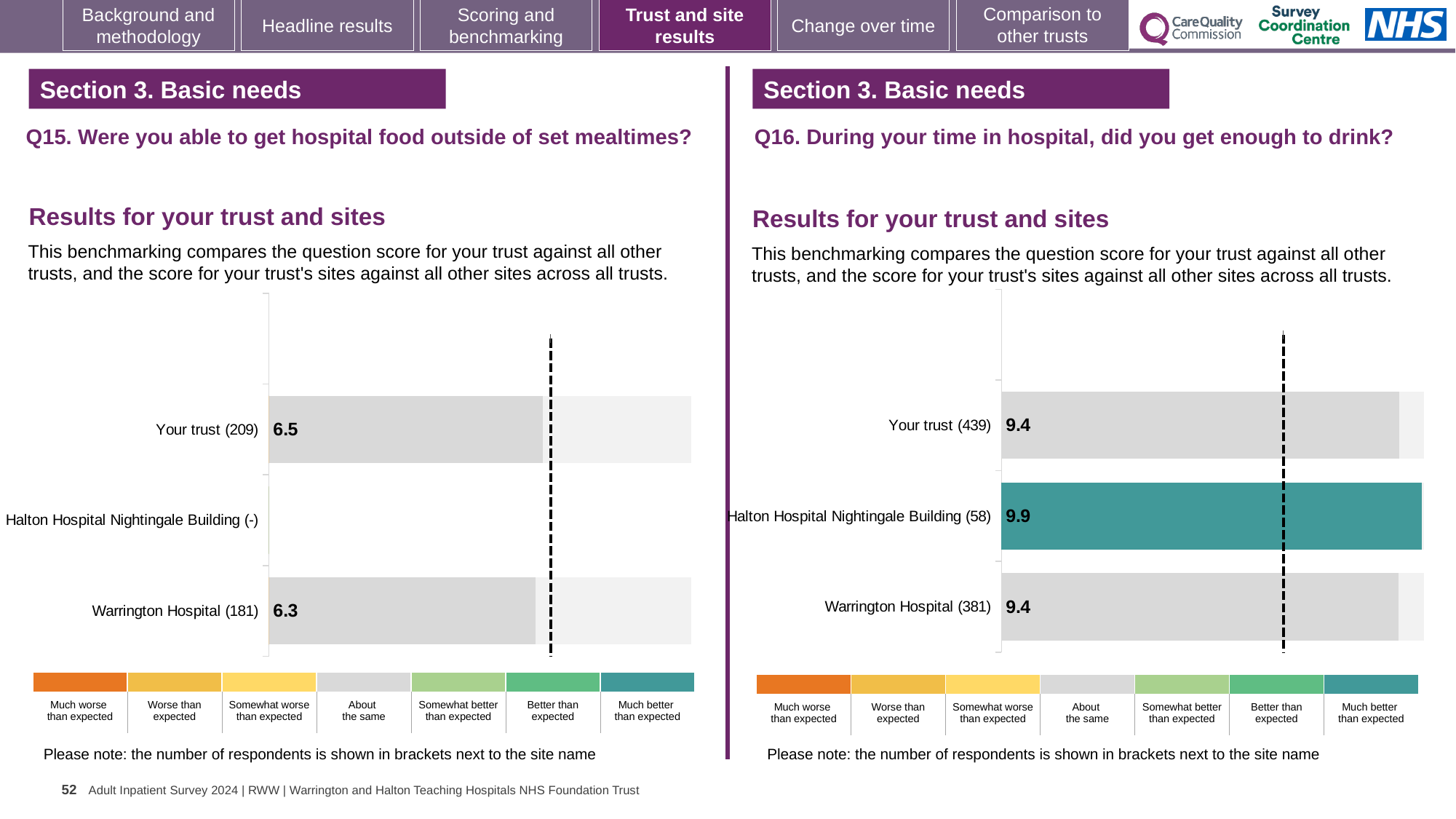
In the Q16 chart (did you get enough to drink), which site has the highest score? Halton Hospital Nightingale Building In the Q15 chart (hospital food outside of set mealtimes), what is the difference between the scores for Your trust and Warrington Hospital? 0.2 In the Q15 chart (hospital food outside of set mealtimes), what is the score for Your trust? 6.5 In the Q16 chart (did you get enough to drink), which is larger: the score for Halton Hospital Nightingale Building or the score for Warrington Hospital? Halton Hospital Nightingale Building In the Q16 chart (did you get enough to drink), what is the difference between the scores for Halton Hospital Nightingale Building and Your trust? 0.5 In the Q16 chart (did you get enough to drink), what is the score for Warrington Hospital? 9.4 In the Q16 chart (did you get enough to drink), what is the score for Halton Hospital Nightingale Building? 9.9 In the Q15 chart (hospital food outside of set mealtimes), what is the score for Warrington Hospital? 6.3 In the Q15 chart (hospital food outside of set mealtimes), how many respondents are shown in brackets for Your trust? 209 In the Q16 chart (did you get enough to drink), how many respondents are shown in brackets for Warrington Hospital? 381 What kind of chart is used in the Q15 chart (hospital food outside of set mealtimes)? Bar chart In the Q16 chart (did you get enough to drink), which benchmark category does the colour of the Halton Hospital Nightingale Building bar correspond to? Much better than expected